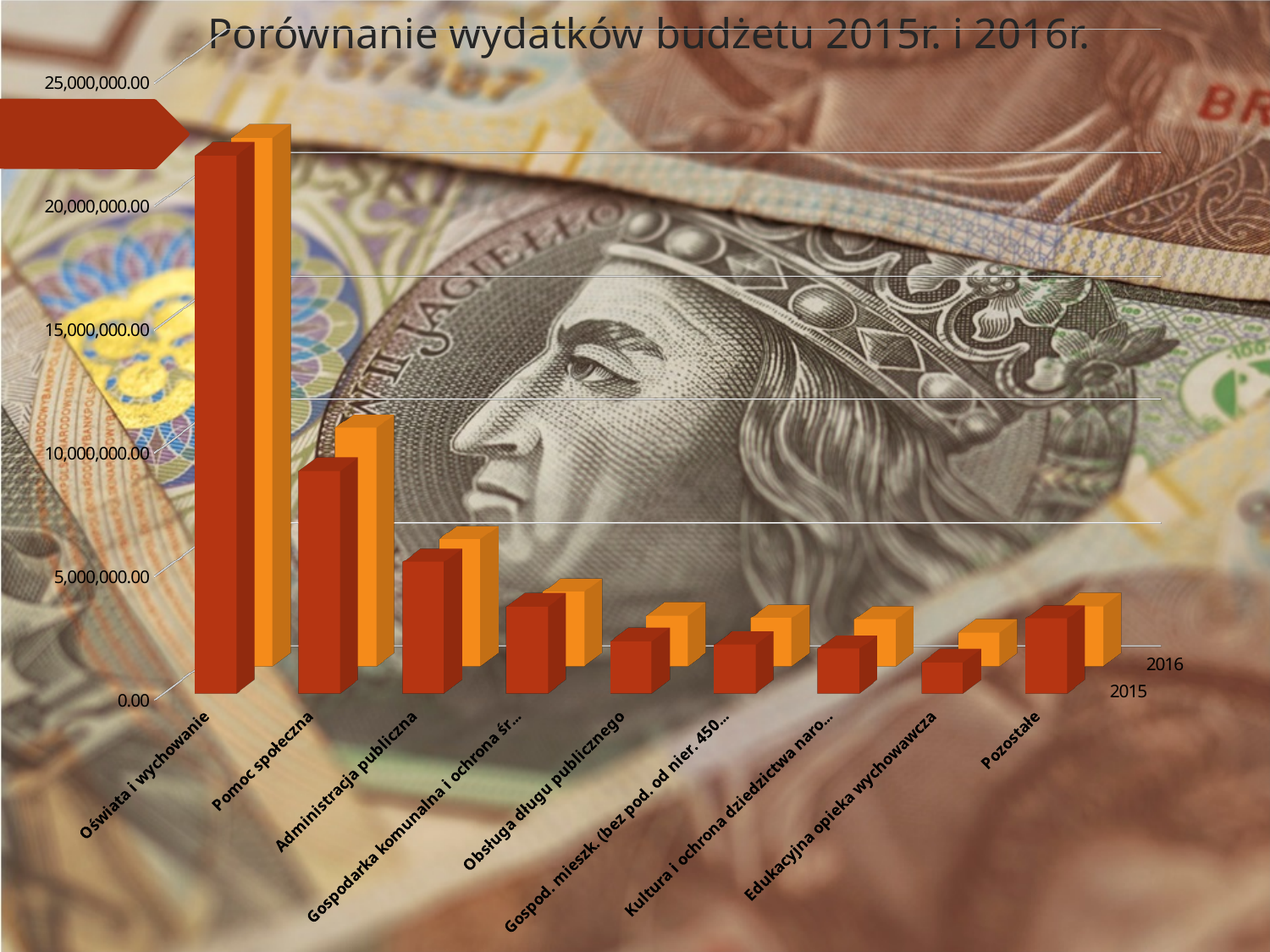
What is the title of the chart? Porównanie wydatków budżetu 2015r. i 2016r. Which category has the highest expenditure in the chart? Oświata i wychowanie Which category has the larger 2016 expenditure, Pomoc społeczna or Administracja publiczna? Pomoc społeczna How many expenditure categories are shown on the x axis? 9 Is the 2015 value for Pomoc społeczna greater or less than 10,000,000.00? less Which category has the larger 2015 expenditure, Oświata i wychowanie or Pomoc społeczna? Oświata i wychowanie How many series does the chart show? 2 Is the 2015 value for Obsługa długu publicznego greater or less than 5,000,000.00? less Which category has the lowest 2015 expenditure? Edukacyjna opieka wychowawcza Is the 2015 value for Oświata i wychowanie greater or less than 20,000,000.00? greater What kind of chart is shown on the slide? bar chart Which two series are plotted in the chart? 2015 and 2016